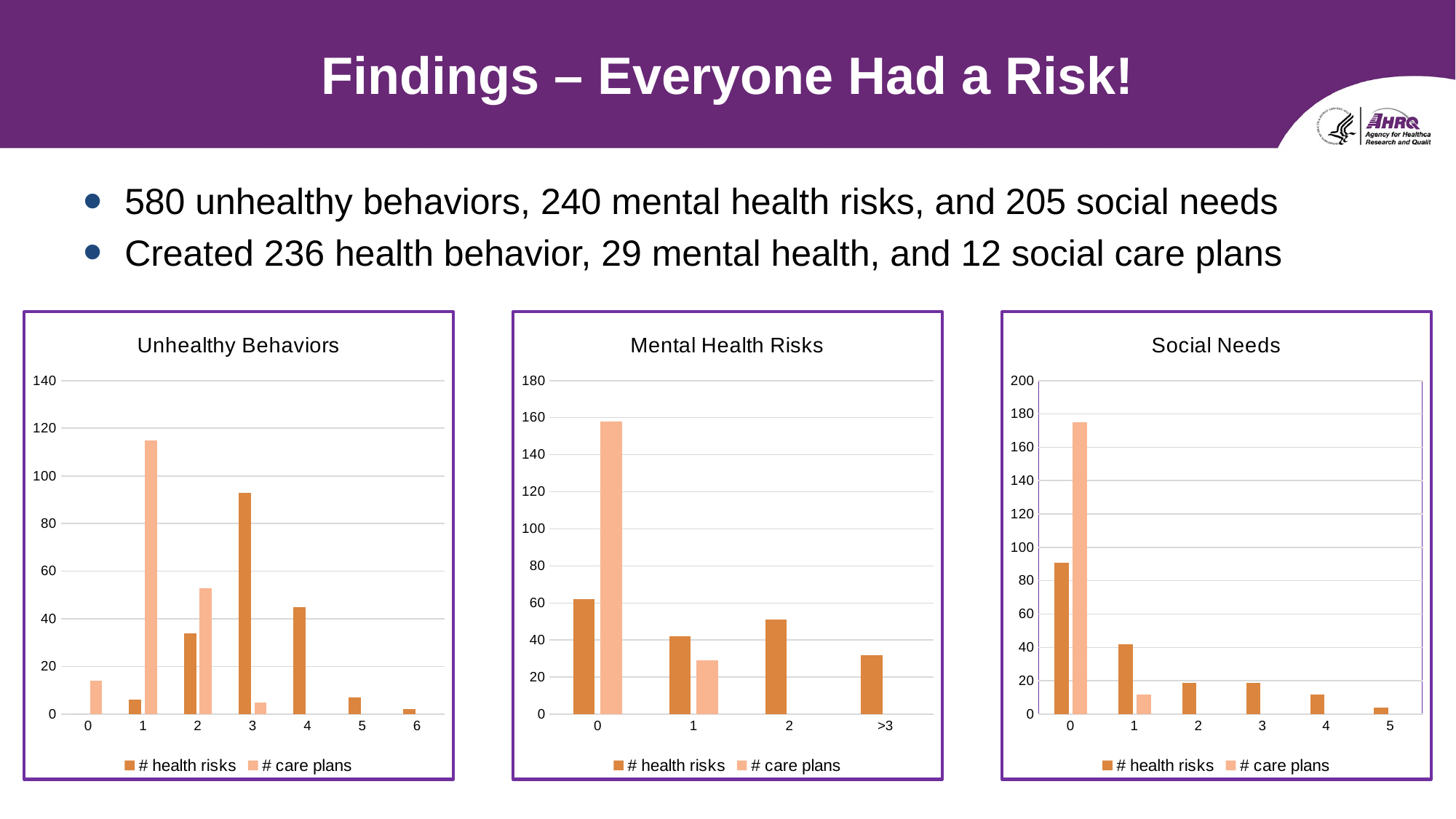
How many categories are shown on the x axis of the Mental Health Risks chart? 4 In the Unhealthy Behaviors chart, which category has the highest # health risks bar? 3 In the Unhealthy Behaviors chart, is the # health risks value for category 4 greater or less than 60? less In the Social Needs chart, is the # health risks value for category 0 greater or less than 80? greater How many series does the legend of the Social Needs chart list? 2 In the Social Needs chart, which category has the lowest # health risks bar? 5 In the Mental Health Risks chart, which category has the highest # care plans bar? 0 In the Social Needs chart, do the # health risks values rise or fall as the category number increases from 0 to 5? fall In the Mental Health Risks chart, which is larger for category 1: # health risks or # care plans? # health risks How many categories are shown on the x axis of the Unhealthy Behaviors chart? 7 In the Mental Health Risks chart, is the # care plans value for category 0 greater or less than 140? greater